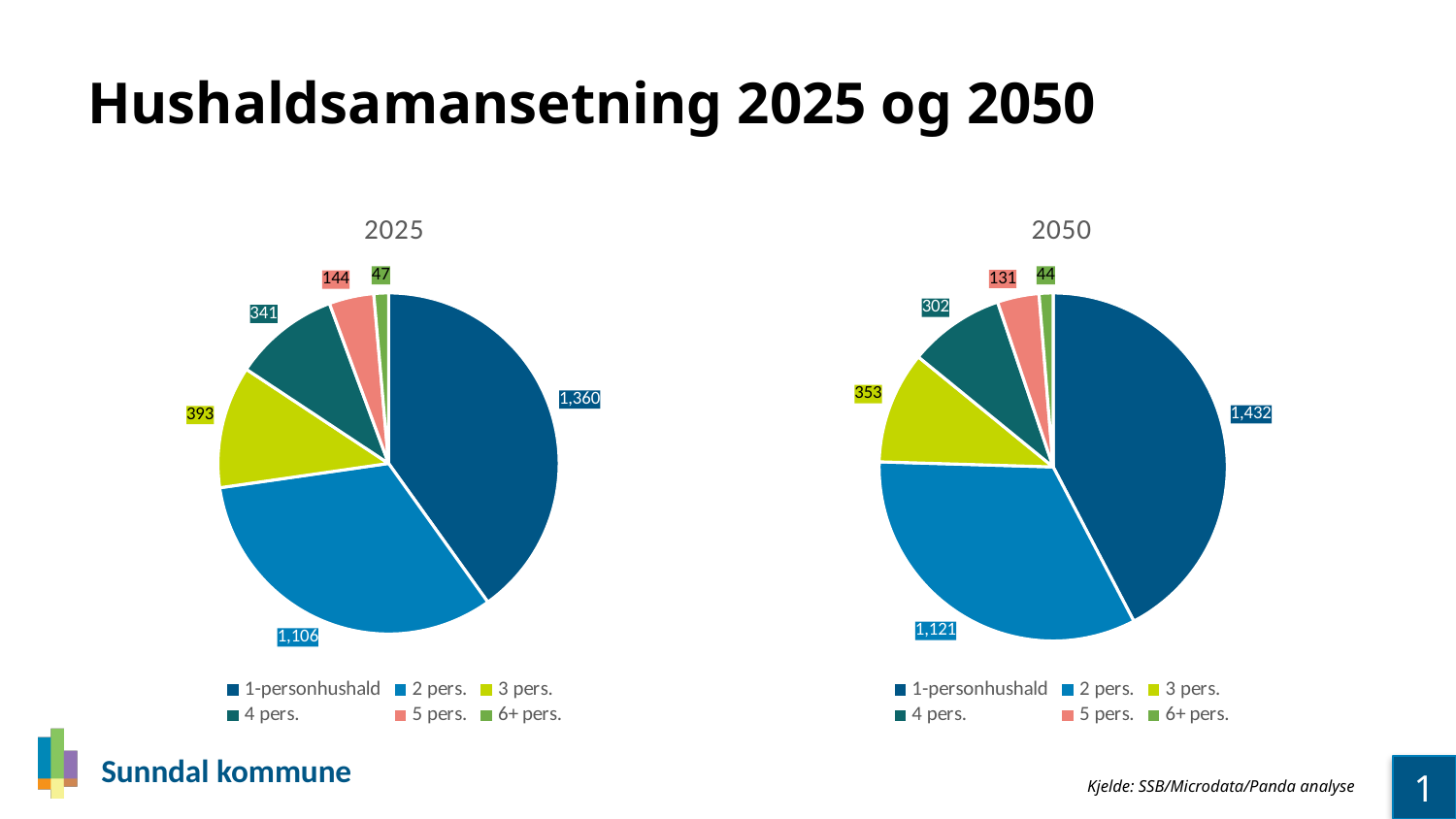
In the 2025 pie chart, what is the value for 1-personhushald? 1,360 In the 2050 pie chart, what is the difference between 4 pers. and 5 pers.? 171 In the 2025 pie chart, what is the value for 5 pers.? 144 Which is larger: 3 pers. in the 2025 chart or 3 pers. in the 2050 chart? 2025 In the 2050 pie chart, which category has the largest slice? 1-personhushald In the 2050 pie chart, what is the value for 3 pers.? 353 In the 2025 pie chart, what is the difference between 1-personhushald and 2 pers.? 254 What kind of chart is used for the 2025 data? Pie chart In the 2050 pie chart, what is the value for 2 pers.? 1,121 In the 2025 pie chart, which category has the smallest slice? 6+ pers. How many categories does the 2050 pie chart show? 6 What is the title of the slide? Hushaldsamansetning 2025 og 2050